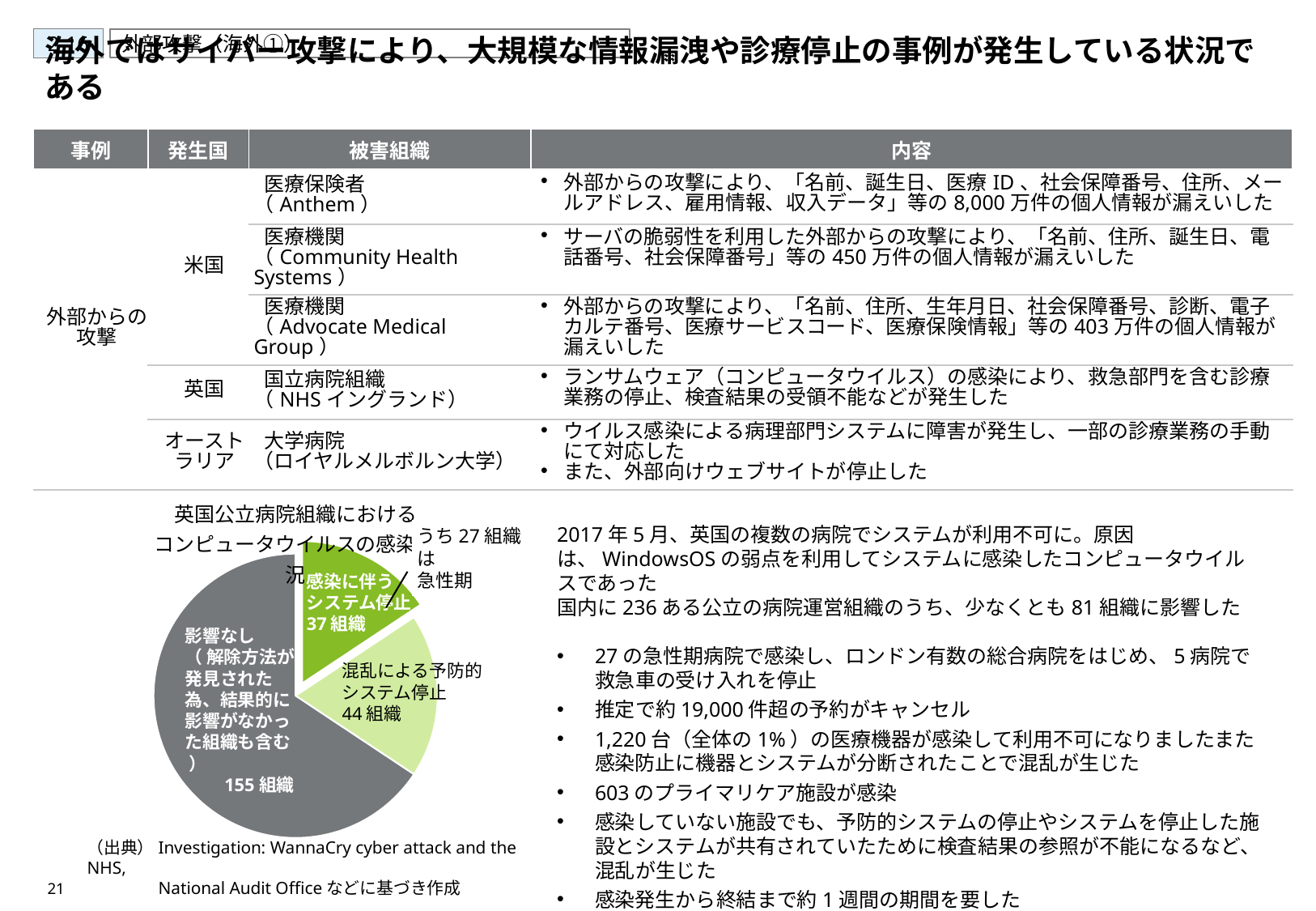
円グラフで「混乱による予防的システム停止」と「感染に伴うシステム停止」の組織数の差はいくつですか？ 7組織 円グラフで「影響なし」と「感染に伴うシステム停止」の組織数の差はいくつですか？ 118組織 円グラフで最も組織数が多い区分はどれですか？ 影響なし 円グラフのタイトルは何ですか？ 英国公立病院組織におけるコンピュータウイルスの感染状況 円グラフで「混乱による予防的システム停止」と「感染に伴うシステム停止」では、どちらの組織数が多いですか？ 混乱による予防的システム停止 円グラフで最も組織数が少ない区分はどれですか？ 感染に伴うシステム停止 円グラフにはいくつの区分がありますか？ 3 円グラフで「感染に伴うシステム停止」の組織数はいくつですか？ 37組織 このスライドのグラフはどの種類のグラフですか？ 円グラフ 円グラフの3つの区分の組織数の合計はいくつですか？ 236組織 円グラフで「混乱による予防的システム停止」の組織数はいくつですか？ 44組織 円グラフで「影響なし」の組織数はいくつですか？ 155組織